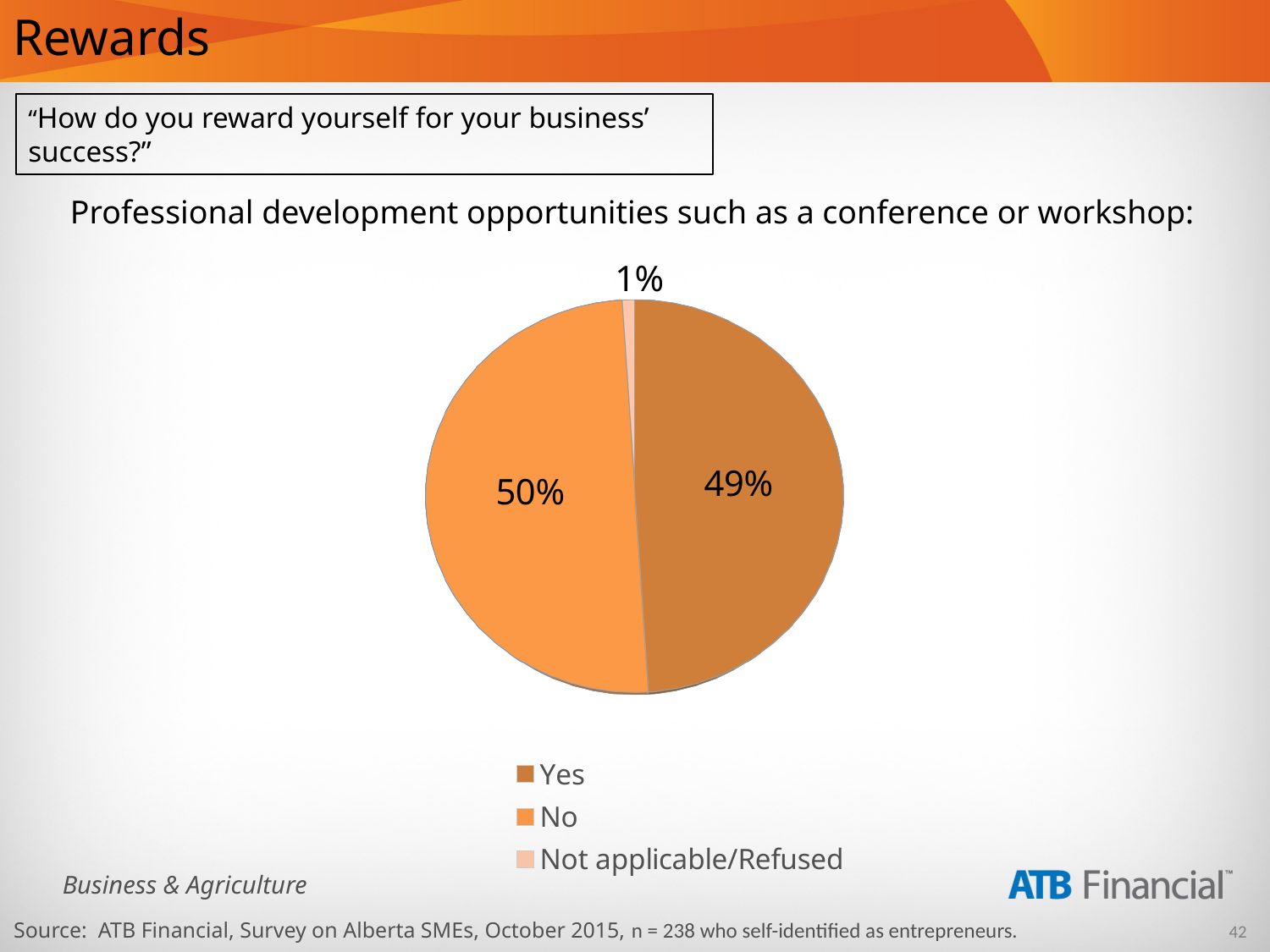
Which legend entry is shown in the lightest colour? Not applicable/Refused What reward option does the pie chart describe? Professional development opportunities such as a conference or workshop What is the combined share of the "Yes" and "No" slices? 99% How many slices does the pie chart have? 3 What percentage of respondents answered "No"? 50% What is the difference in percentage points between the "No" and "Yes" slices? 1 What kind of chart is shown on the slide? pie chart How many entries does the legend list? 3 Which category has the smallest slice of the pie? Not applicable/Refused What percentage of respondents are "Not applicable/Refused"? 1% What percentage of respondents answered "Yes"? 49%